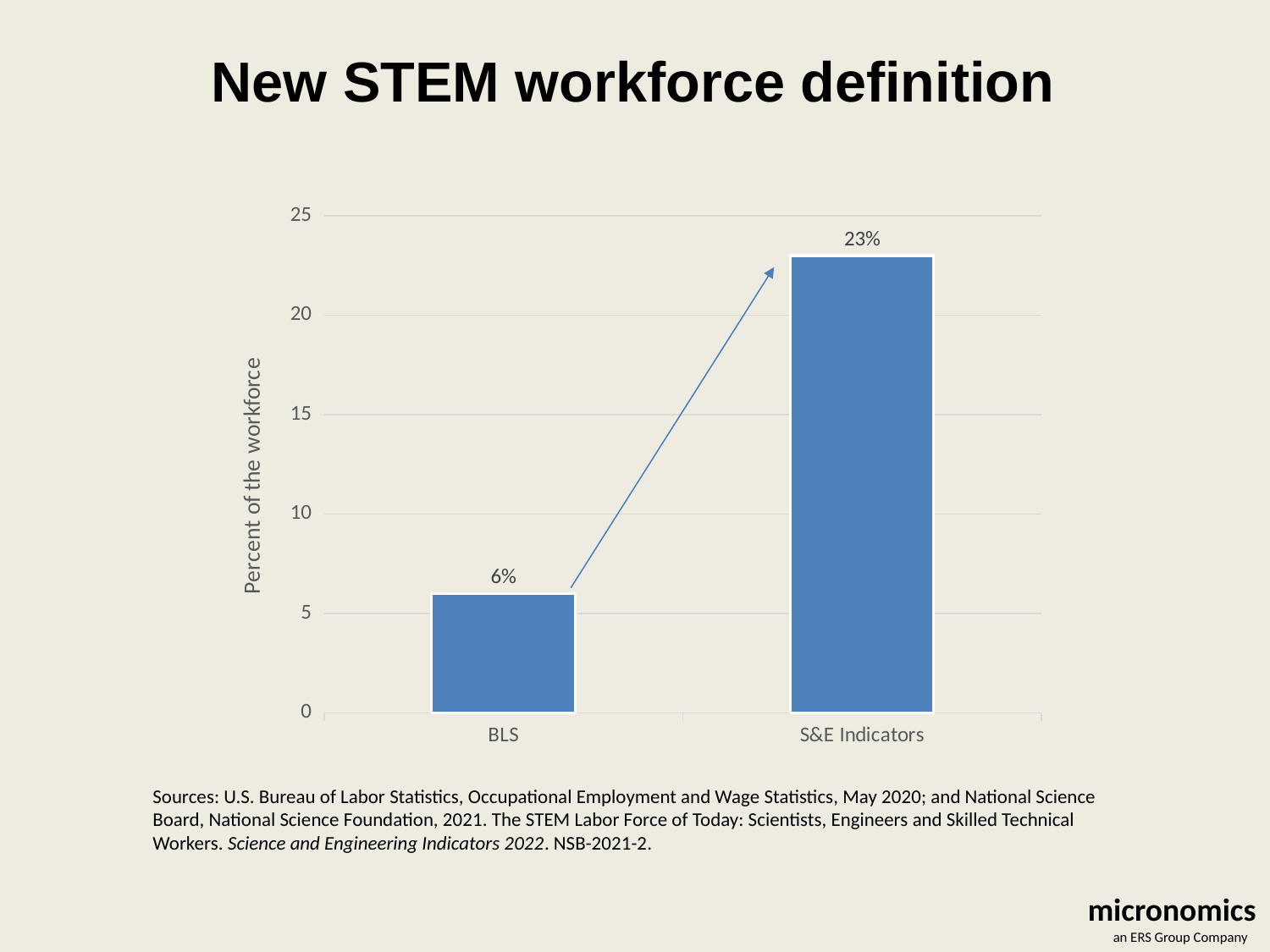
How many categories are shown on the x axis? 2 What is the value for BLS? 6% What is the title of the slide? New STEM workforce definition Is the value for BLS greater or less than 10? less Is the value for S&E Indicators greater or less than 20? greater What is the value for S&E Indicators? 23% Which category has the highest value? S&E Indicators Which is larger, the value for BLS or the value for S&E Indicators? S&E Indicators Which category has the lowest value? BLS What is the difference between the S&E Indicators value and the BLS value? 17% What is the label of the vertical axis? Percent of the workforce What kind of chart is shown on the slide? bar chart